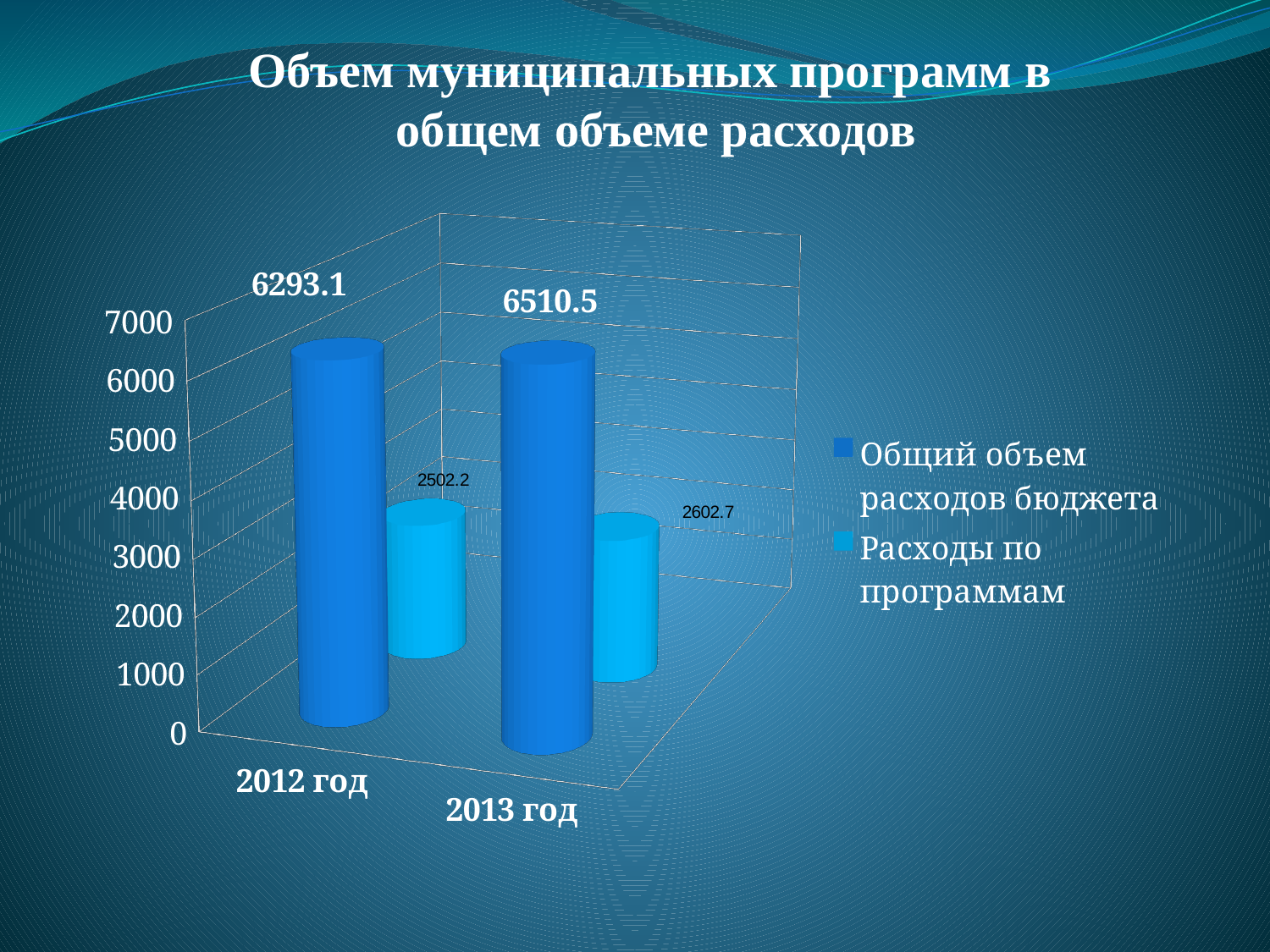
Which year has the lower value for "Расходы по программам"? 2012 год What is the value of "Расходы по программам" for 2013 год? 2602.7 Which year has the higher value for "Общий объем расходов бюджета"? 2013 год Does "Общий объем расходов бюджета" rise or fall from 2012 год to 2013 год? rise How many series does the legend list? 2 What is the value of "Общий объем расходов бюджета" for 2012 год? 6293.1 What is the difference between "Расходы по программам" in 2013 год and in 2012 год? 100.5 What is the difference between "Общий объем расходов бюджета" in 2013 год and in 2012 год? 217.4 What is the value of "Расходы по программам" for 2012 год? 2502.2 What kind of chart is shown on the slide? bar chart What is the value of "Общий объем расходов бюджета" for 2013 год? 6510.5 Is the value for "Расходы по программам" in 2012 год greater or less than 3000? less